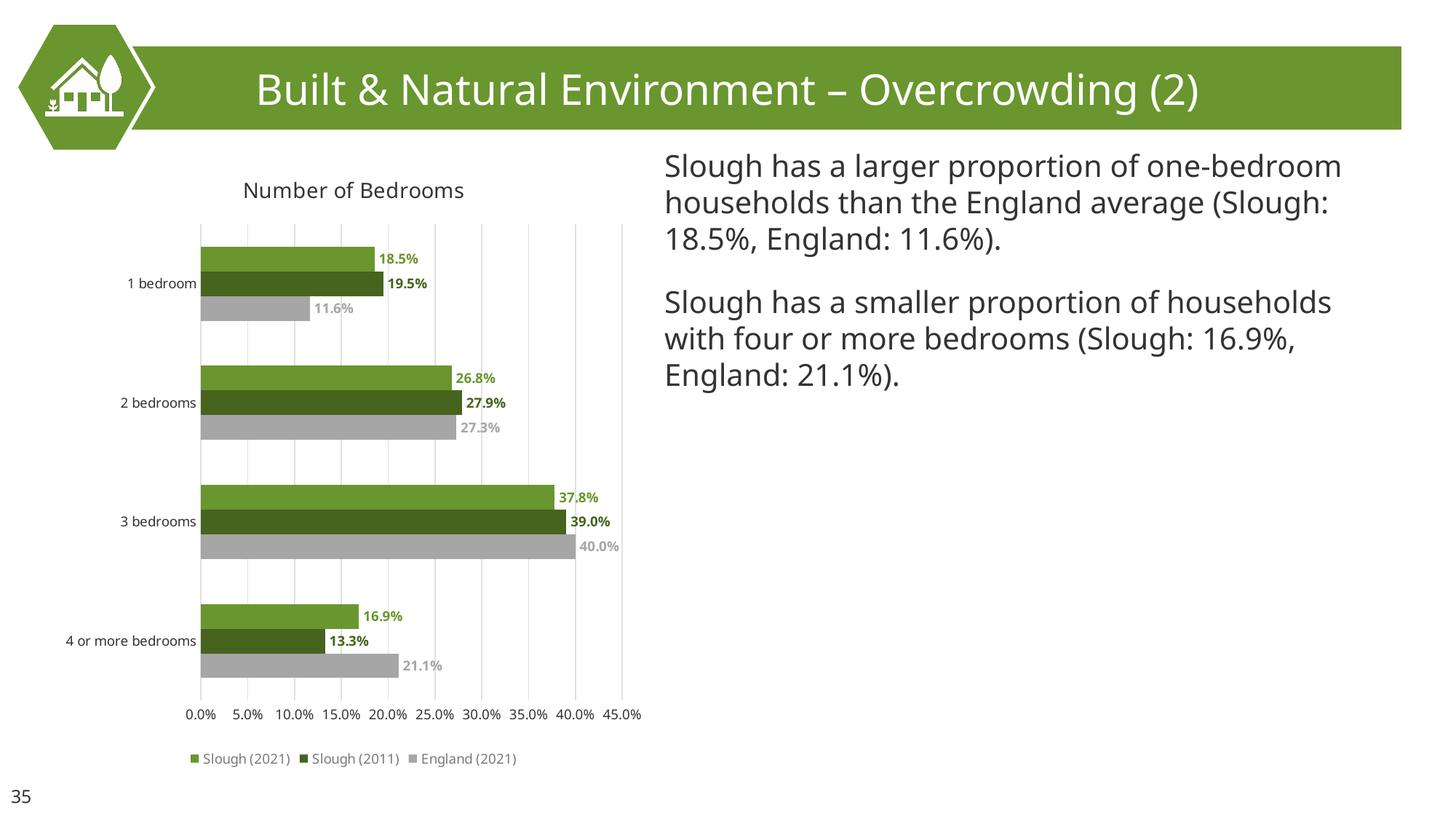
Which category has the lowest value for England (2021)? 1 bedroom What is the value for Slough (2021) for 1 bedroom? 18.5% What is the value for Slough (2011) for 4 or more bedrooms? 13.3% What is the value for England (2021) for 3 bedrooms? 40.0% How many series does the legend list? 3 What is the difference between Slough (2021) and England (2021) for 1 bedroom? 6.9% How many bedroom categories are shown on the chart? 4 Which category has the highest value for Slough (2021)? 3 bedrooms What is the title of the chart? Number of Bedrooms Which is larger for 2 bedrooms: Slough (2011) or England (2021)? Slough (2011) What is the difference between England (2021) and Slough (2021) for 4 or more bedrooms? 4.2% What kind of chart is shown on the slide? Bar chart